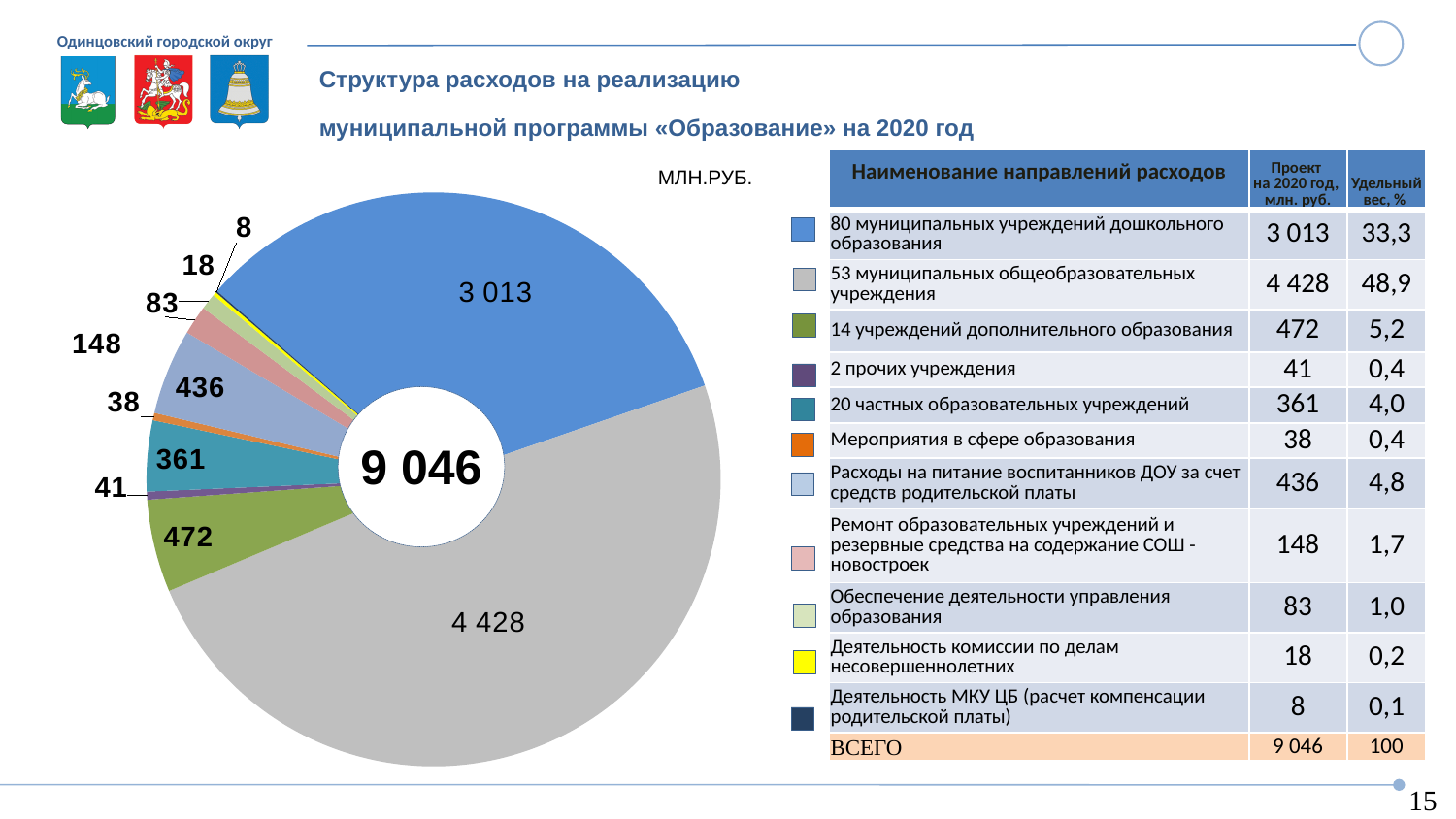
What is the value for the 20 private educational institutions (20 частных образовательных учреждений)? 361 How many categories (slices) does the chart have? 11 What is the difference between the values for the 53 general education institutions (4 428) and the 80 preschool institutions (3 013)? 1 415 Which category has the smallest slice of the chart? Деятельность МКУ ЦБ (расчет компенсации родительской платы) What share of the total do the 80 municipal preschool institutions account for, according to the table? 33,3 Which is larger: the value for 14 institutions of additional education or the value for food expenses for preschool pupils (Расходы на питание воспитанников ДОУ)? 14 учреждений дополнительного образования (472) What is the value for the 80 municipal preschool institutions (80 муниципальных учреждений дошкольного образования)? 3 013 Which category has the largest slice of the chart? 53 муниципальных общеобразовательных учреждения What is the value for the 53 municipal general education institutions (53 муниципальных общеобразовательных учреждения)? 4 428 What unit is indicated above the chart? МЛН.РУБ. What kind of chart is shown on the slide? Pie (doughnut) chart What total is shown in the centre of the doughnut chart? 9 046